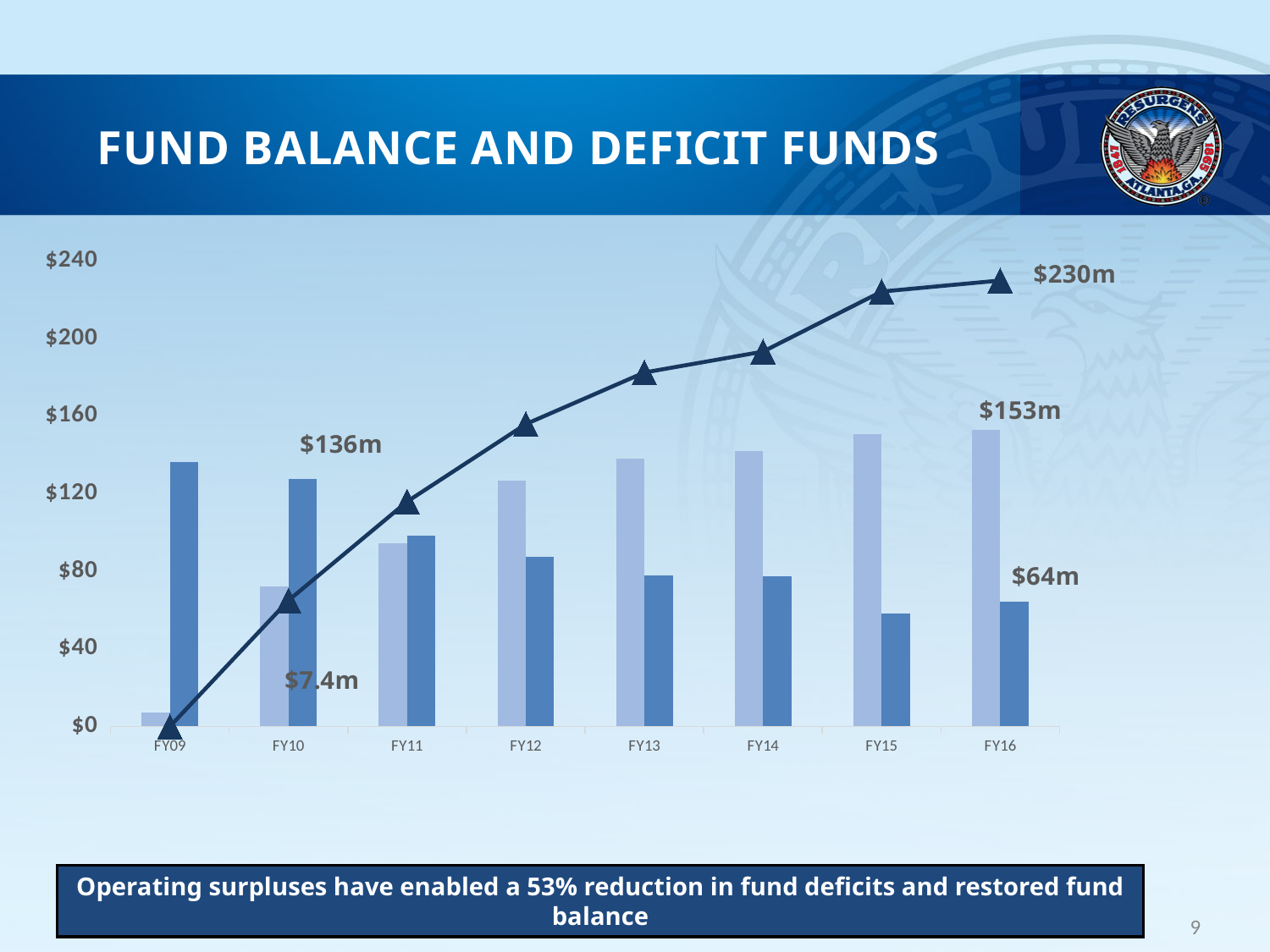
Does the line rise or fall from FY09 to FY16? Rises In which fiscal year does the line reach its highest point? FY16 How many fiscal years are shown on the x axis? 8 What value is labelled on the line at FY16? $230m At FY16, which is larger: the light blue bar or the dark blue bar? The light blue bar What value is labelled on the light blue bar at FY16? $153m Is the line value at FY13 greater or less than $160? greater What value is labelled on the dark blue bar at FY16? $64m What is the difference between the light blue bar ($153m) and the dark blue bar ($64m) at FY16? $89m In which fiscal year is the light blue bar the lowest? FY09 What kind of chart is shown on the slide? A combination bar and line chart Is the dark blue bar at FY15 greater or less than $80? less